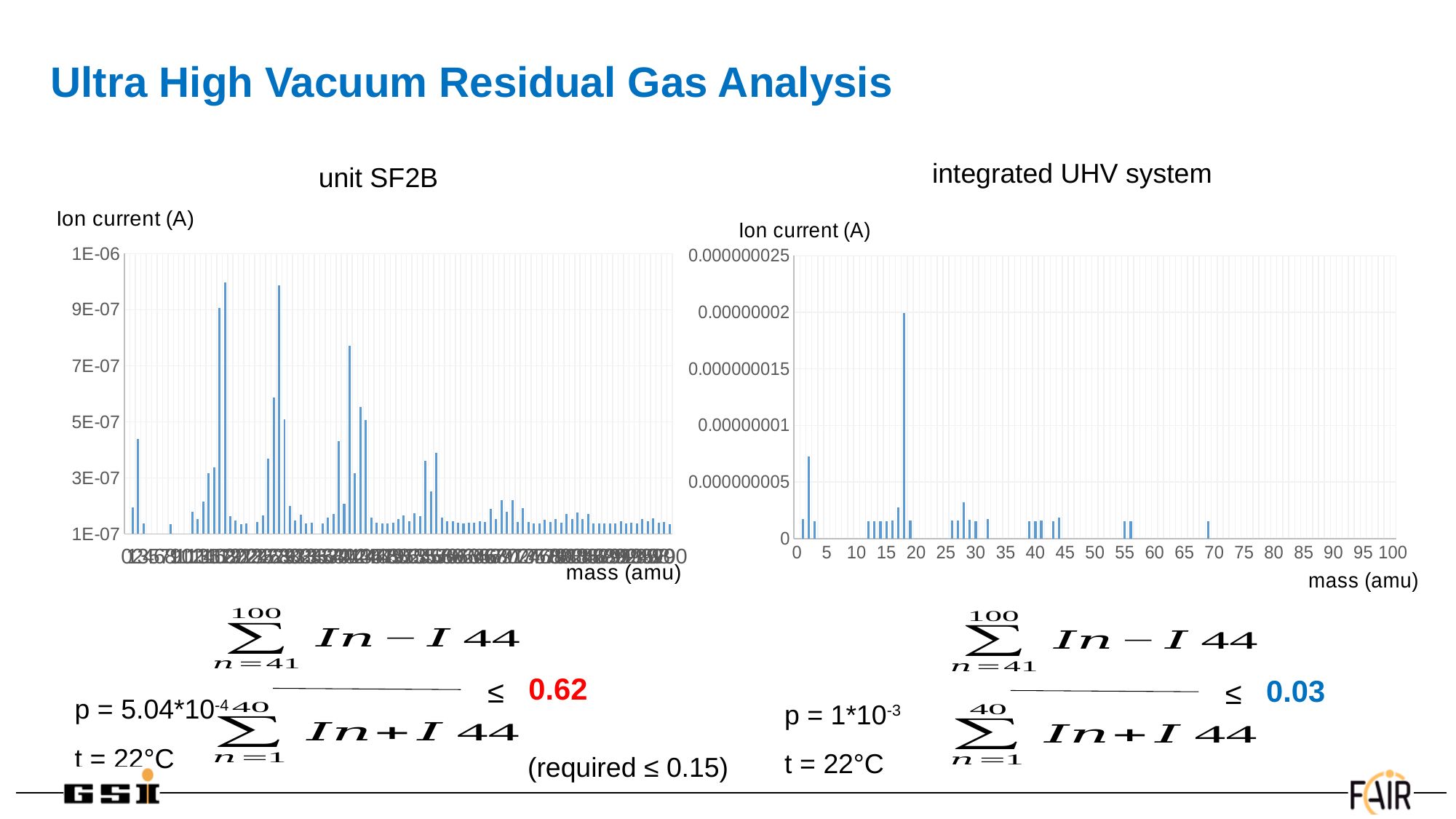
In the 'unit SF2B' chart, is the value of the tallest bar greater or less than 9E-07? greater What is the x-axis label of the 'unit SF2B' chart? mass (amu) In the 'unit SF2B' chart, is the value of the tallest bar greater or less than 1E-06? less What is the y-axis label of the 'integrated UHV system' chart? Ion current (A) In the 'integrated UHV system' chart, is the value of the tallest bar greater or less than 0.000000015? greater In the 'integrated UHV system' chart, which is larger: the bar at mass 2 amu or the bar at mass 28 amu? mass 2 amu In the 'integrated UHV system' chart, between which two labelled x-axis ticks does the tallest bar fall? 15 and 20 What kind of chart is the 'unit SF2B' chart? bar chart What kind of chart is the 'integrated UHV system' chart? bar chart